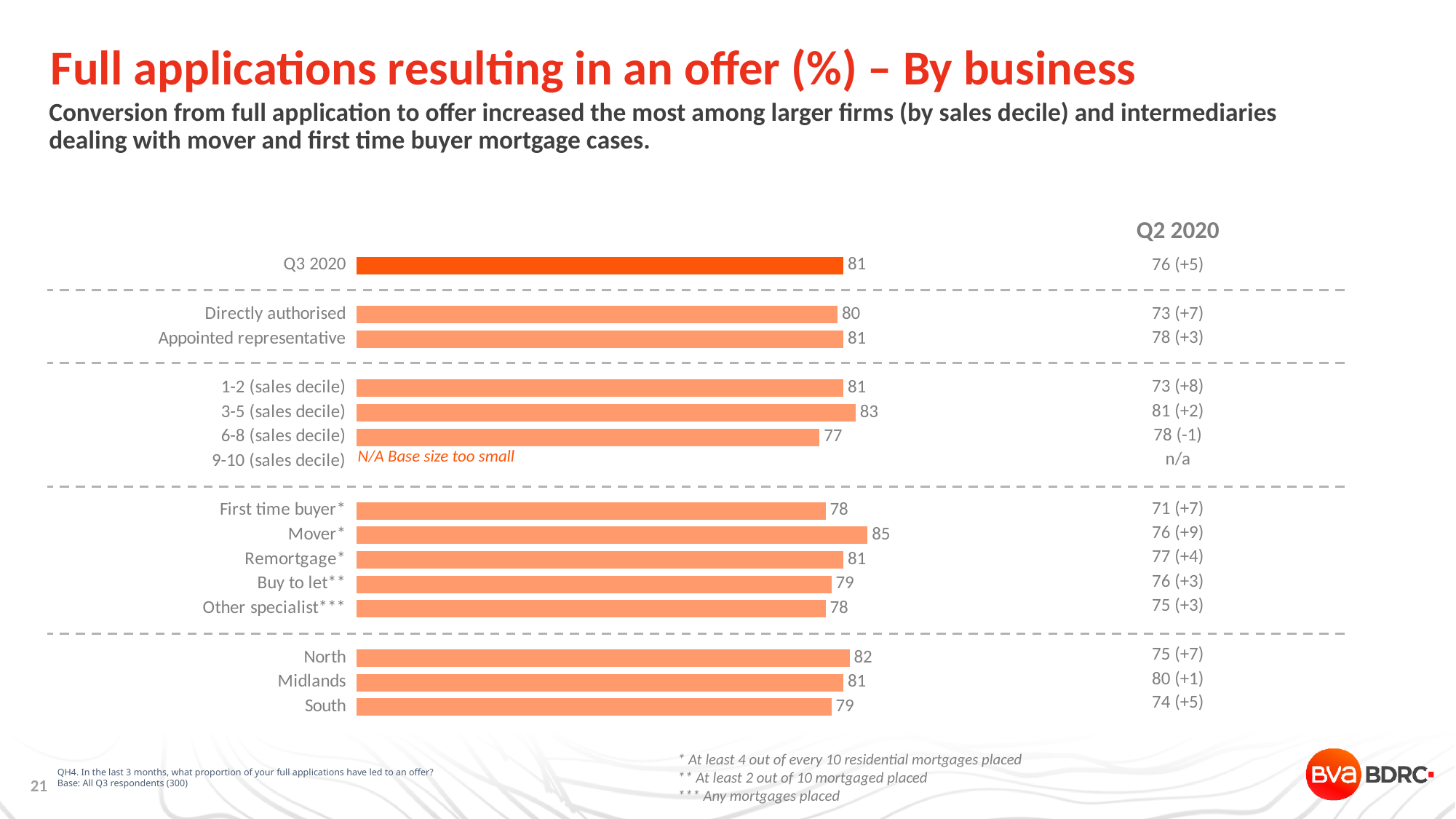
What is the difference between the values for North and South? 3 What is the value for 6-8 (sales decile)? 77 What kind of chart is shown on the slide? Bar chart What is the difference between the values for Mover and First time buyer? 7 Which category among the plotted bars has the lowest value? 6-8 (sales decile) What is the value for Mover? 85 Which has a larger value, Directly authorised or 3-5 (sales decile)? 3-5 (sales decile) What is the value for Q3 2020 overall? 81 Which category has the highest value in the chart? Mover Which category is marked as N/A because the base size is too small? 9-10 (sales decile) What is the Q2 2020 value shown for Mover? 76 (+9) What is the value for North? 82